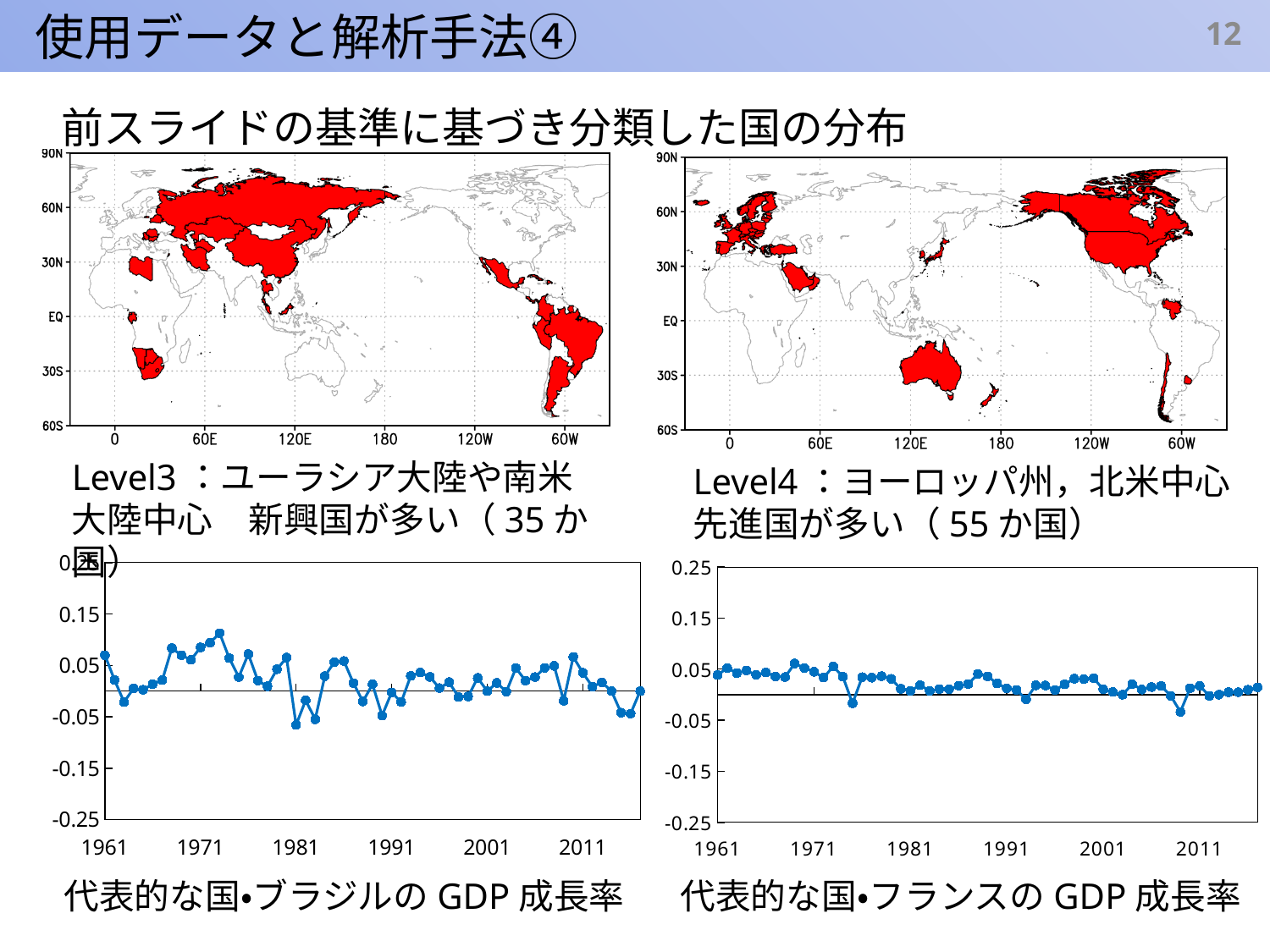
What is the maximum value shown on the y axis of the bottom-right chart (フランスのGDP成長率)? 0.25 In the bottom-right chart (フランスのGDP成長率), is the value for 2011 greater or less than 0.05? less What kind of chart is the bottom-right chart showing France's GDP growth rate? line chart In the bottom-left chart (ブラジルのGDP成長率), is the value for 1961 greater or less than 0.05? greater Which chart reaches a lower minimum value, the Brazil GDP growth chart or the France GDP growth chart? Brazil GDP growth chart In the bottom-left chart (ブラジルのGDP成長率), is the lowest value on the line greater or less than -0.15? greater Which chart reaches a higher peak value, the Brazil GDP growth chart or the France GDP growth chart? Brazil GDP growth chart In the bottom-right chart (フランスのGDP成長率), do the values generally rise or fall from 1961 to 2011? fall What is the first year shown on the x axis of the bottom-left chart (ブラジルのGDP成長率)? 1961 What kind of chart is the bottom-left chart showing Brazil's GDP growth rate? line chart